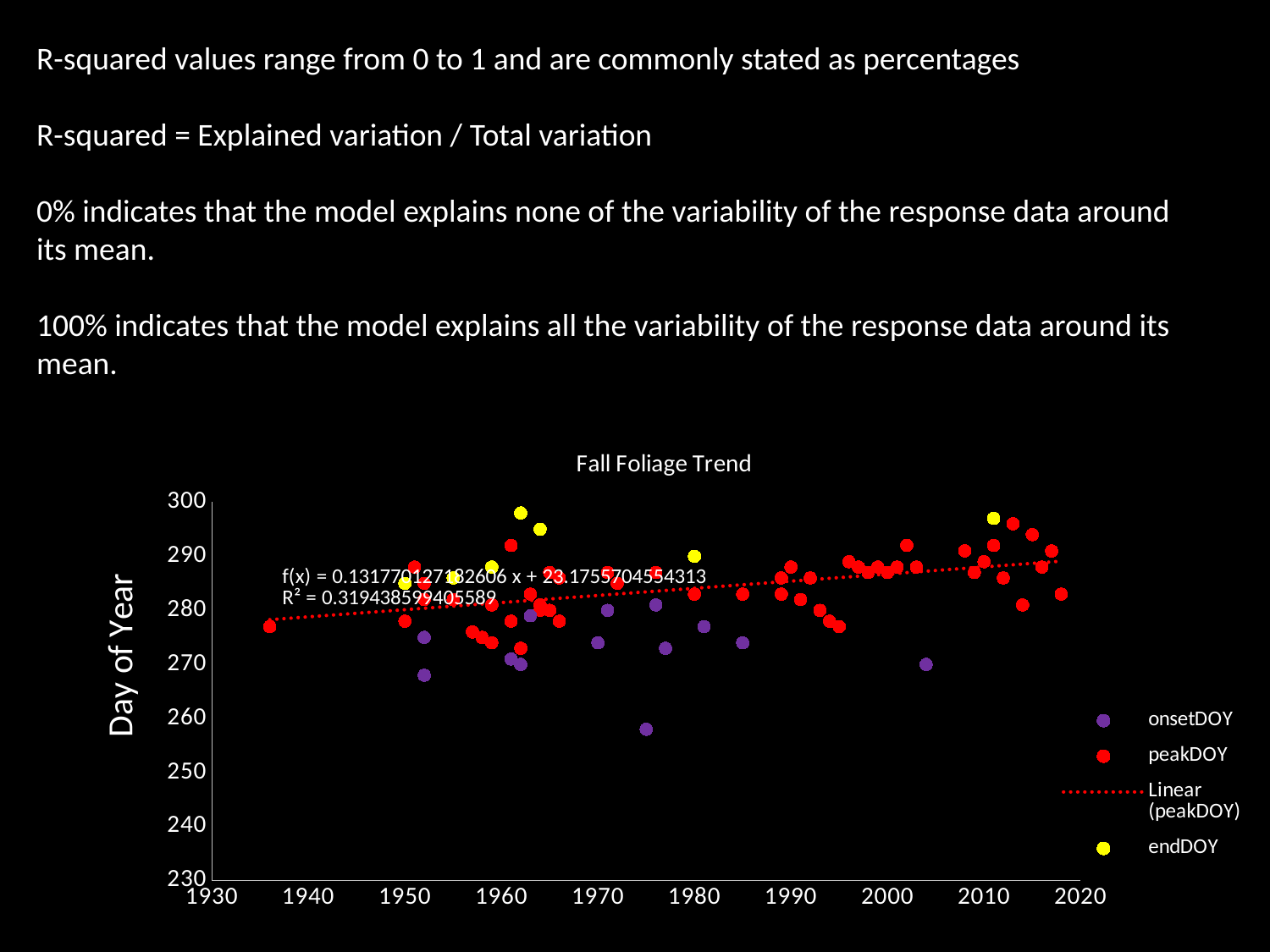
Is the endDOY point near 1962 greater or less than 290? greater Which series contains the lowest plotted point on the chart? onsetDOY Which series contains the highest plotted points on the chart? endDOY What R-squared value is printed on the chart for the peakDOY trendline? 0.319438599405589 Does the linear trendline for peakDOY rise or fall from 1930 to 2020? rise How many entries does the chart legend list? 4 What is the lowest value shown on the vertical axis? 230 What is the title of the chart? Fall Foliage Trend What kind of chart is shown on the slide? scatter chart Is the lowest onsetDOY point (around 1975) greater or less than 260? less What is the label on the vertical axis of the chart? Day of Year Is the earliest peakDOY point (around 1936) greater or less than 270? greater